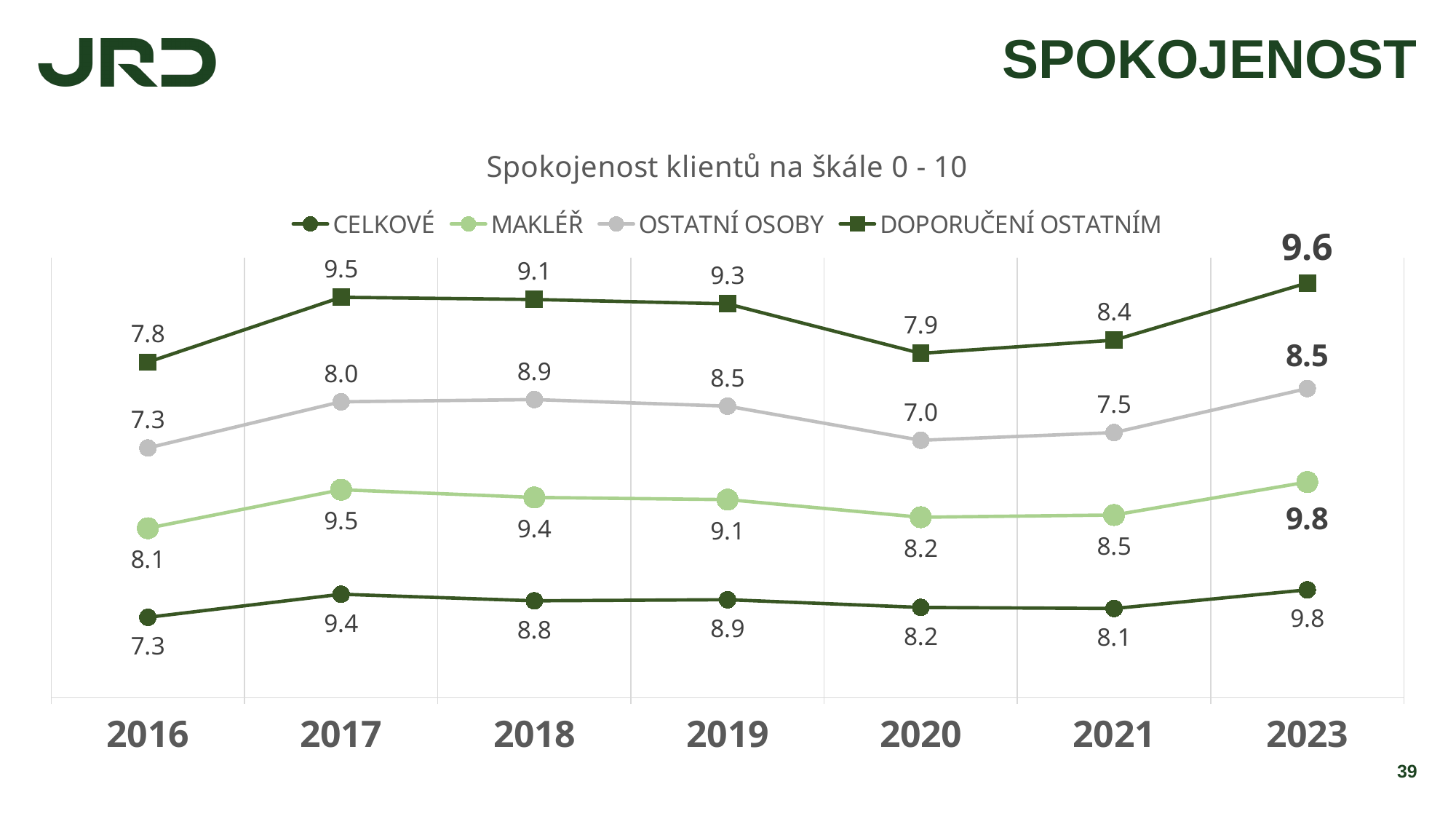
What is the title of the chart? Spokojenost klientů na škále 0 - 10 What is the value for OSTATNÍ OSOBY in 2020? 7.0 Does the MAKLÉŘ value rise or fall from 2021 to 2023? rise In which year is the OSTATNÍ OSOBY value lowest? 2020 What is the value for DOPORUČENÍ OSTATNÍM in 2023? 9.6 How many series does the legend list? 4 What is the value for MAKLÉŘ in 2017? 9.5 How many years are shown on the x axis? 7 What is the value for CELKOVÉ in 2016? 7.3 What kind of chart is shown on the slide? line chart What is the difference between the CELKOVÉ values in 2023 and 2021? 1.7 In which year is the DOPORUČENÍ OSTATNÍM value highest? 2023